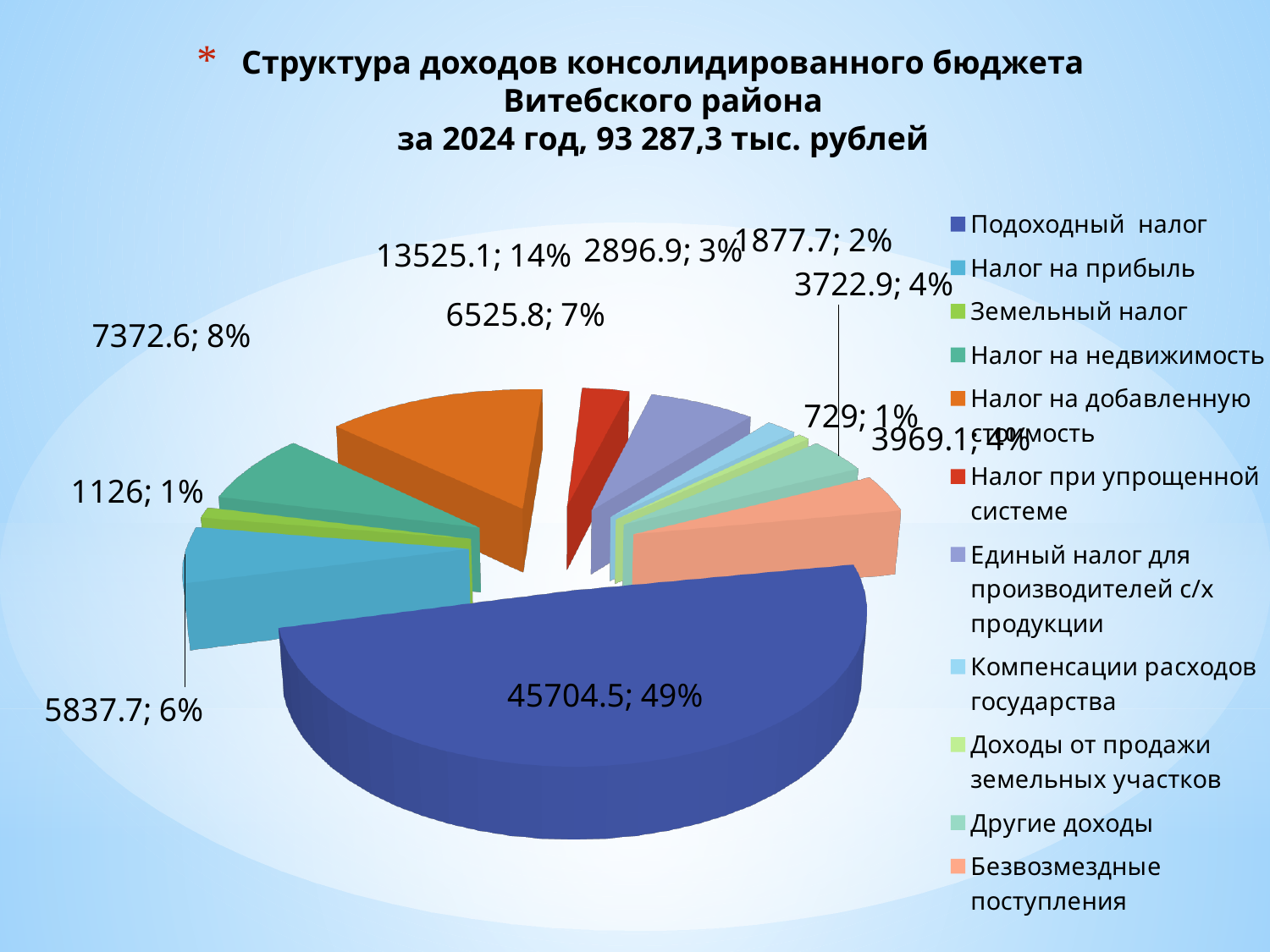
What is the value shown for Подоходный налог? 45704.5 How many categories does the legend of the pie chart list? 11 What is the value shown for Налог на добавленную стоимость? 13525.1 Which is larger, the value for Налог на прибыль or the value for Налог на недвижимость? Налог на недвижимость What is the value shown for Налог на прибыль? 5837.7 According to the chart title, what is the total income of the consolidated budget for 2024? 93 287,3 тыс. рублей What share of the pie does Налог на недвижимость represent? 8% What type of chart is shown on the slide? pie chart What is the smallest value labelled on the pie chart? 729 What is the difference between the values for Подоходный налог and Налог на добавленную стоимость? 32179.4 What share of the pie does Подоходный налог represent? 49% Which category has the largest slice of the pie? Подоходный налог